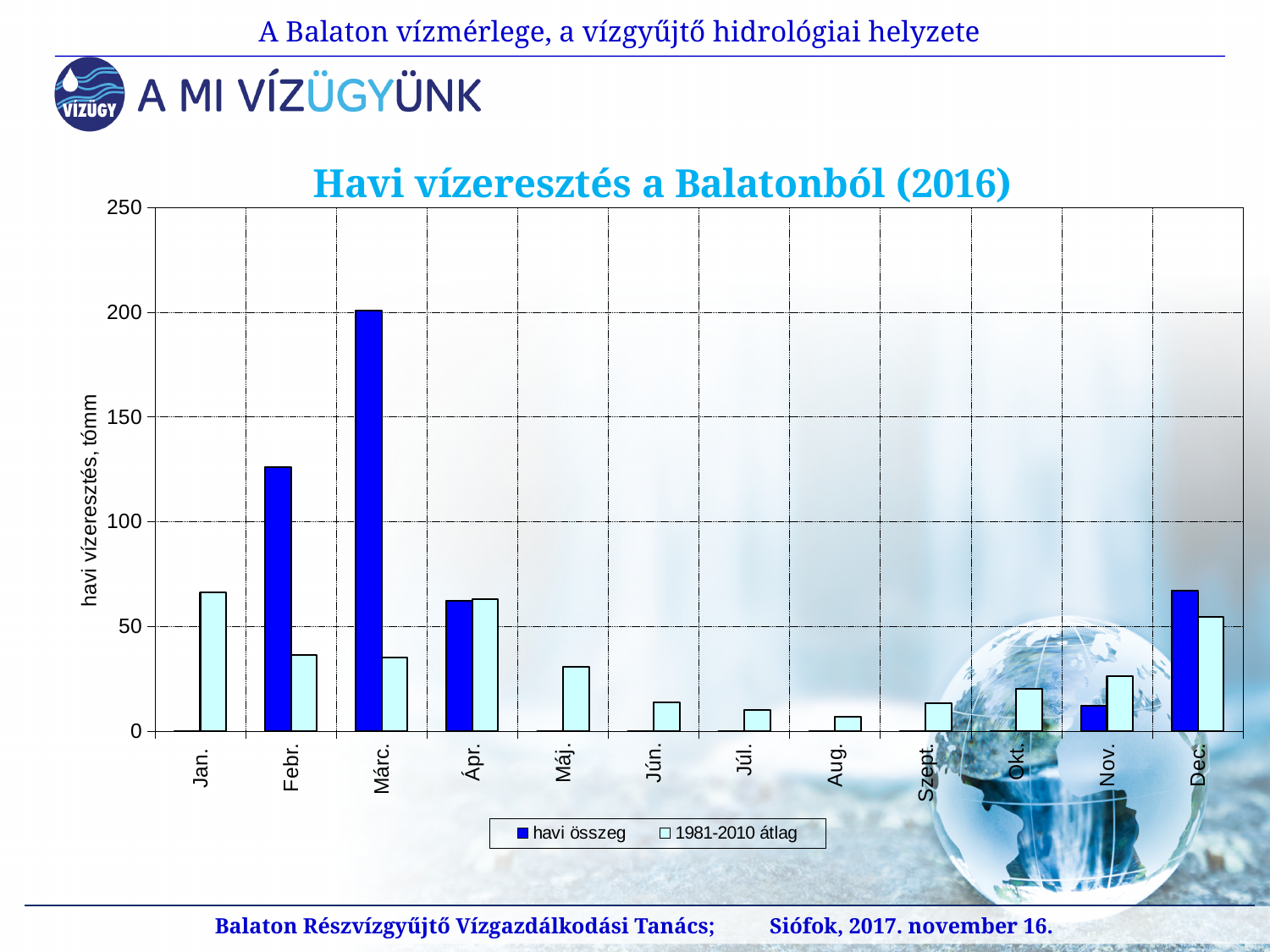
Is the 'havi összeg' value for Márc. greater or less than 150? greater For Febr., which is larger: 'havi összeg' or '1981-2010 átlag'? havi összeg Is the 'havi összeg' value for Febr. greater or less than 100? greater How many series does the legend list? 2 What kind of chart is shown on the slide? bar chart Is the '1981-2010 átlag' value for Jan. greater or less than 50? greater Which month has the highest 'havi összeg' value? Márc. What is the title of the chart? Havi vízeresztés a Balatonból (2016) For Jan., which is larger: 'havi összeg' or '1981-2010 átlag'? 1981-2010 átlag What are the two series named in the legend? havi összeg; 1981-2010 átlag How many months (categories) are shown on the x axis? 12